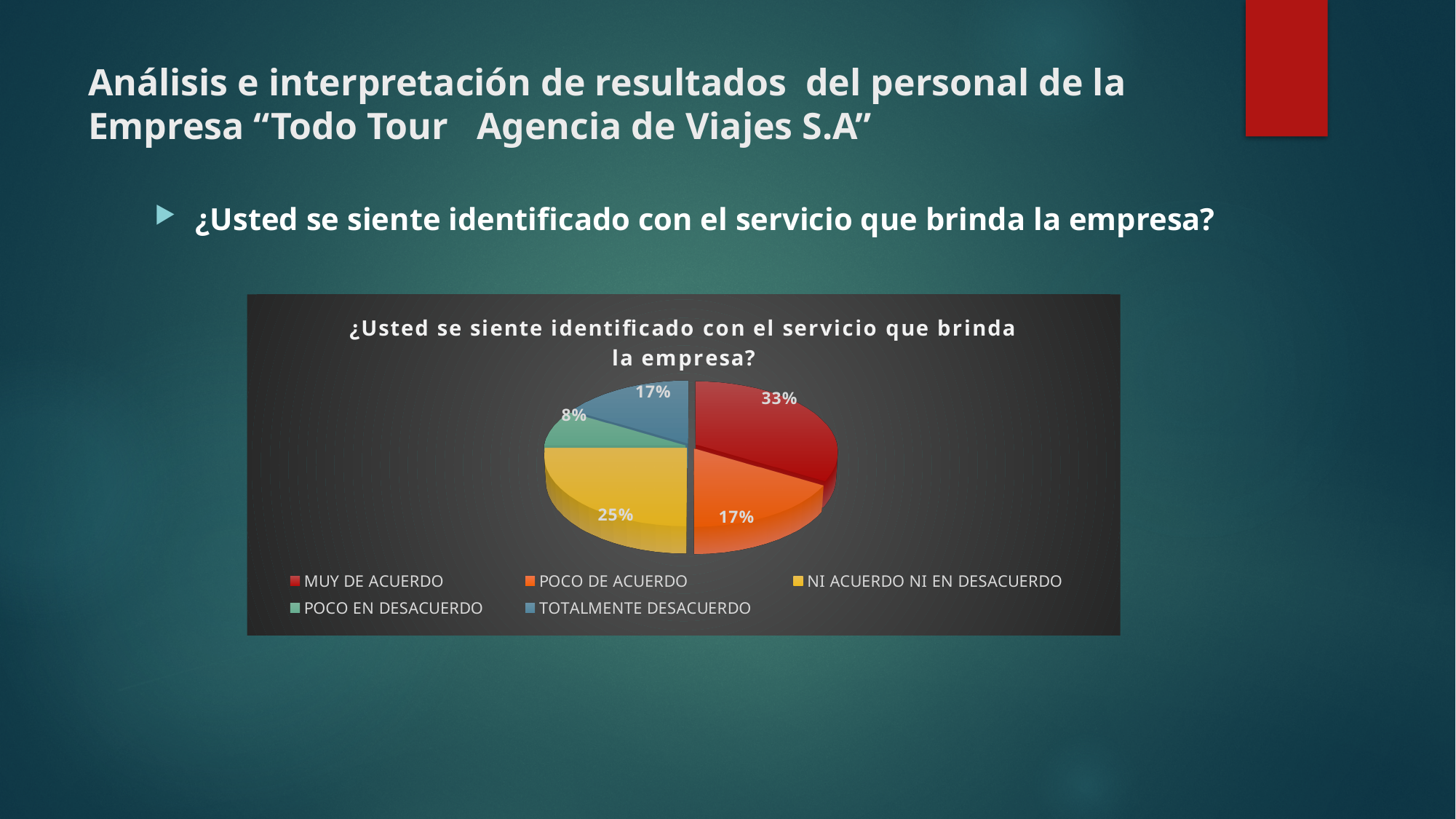
What percentage of the pie corresponds to TOTALMENTE DESACUERDO? 17% Which category has the smallest share of the pie? POCO EN DESACUERDO What colour is the slice for NI ACUERDO NI EN DESACUERDO? Yellow What type of chart is shown on the slide? Pie chart What percentage of the pie corresponds to MUY DE ACUERDO? 33% What percentage of the pie corresponds to NI ACUERDO NI EN DESACUERDO? 25% Which category has the largest share of the pie? MUY DE ACUERDO What percentage of the pie corresponds to POCO EN DESACUERDO? 8% What is the title of the pie chart? ¿Usted se siente identificado con el servicio que brinda la empresa? What is the difference in percentage points between MUY DE ACUERDO and NI ACUERDO NI EN DESACUERDO? 8 How many categories does the legend of the pie chart list? 5 Which is larger, the share for POCO DE ACUERDO or the share for POCO EN DESACUERDO? POCO DE ACUERDO